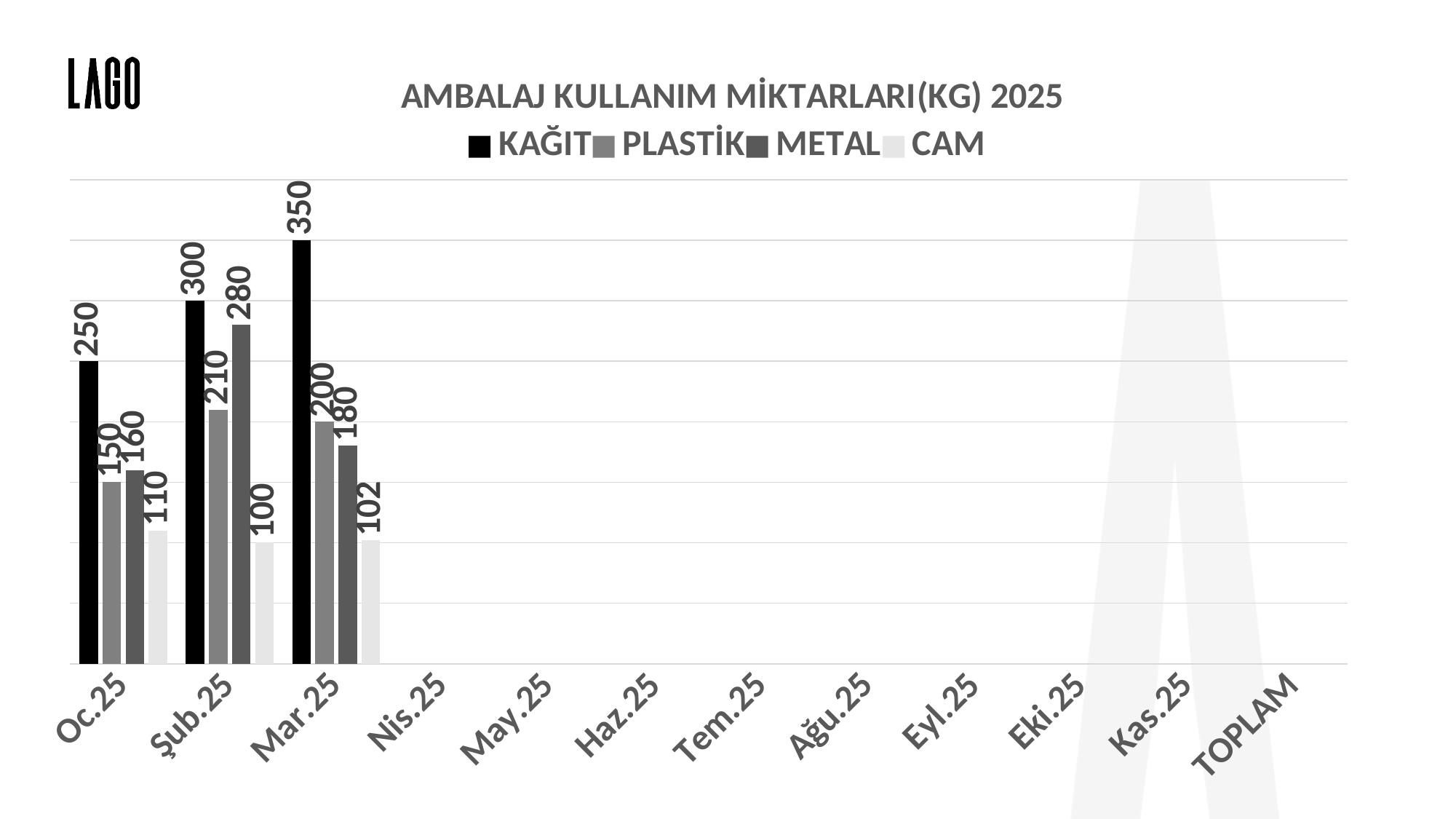
Do the KAĞIT values rise or fall from Oc.25 to Mar.25? Rise What is the KAĞIT value for Mar.25? 350 How many categories are shown on the x axis? 12 How many series does the legend list? 4 What is the CAM value for Oc.25? 110 In which month is the KAĞIT value highest? Mar.25 What kind of chart is shown on the slide? Bar chart What is the PLASTİK value for Şub.25? 210 Which is larger, the METAL value for Şub.25 or the METAL value for Mar.25? Şub.25 In which month is the CAM value lowest? Şub.25 What is the METAL value for Şub.25? 280 What is the difference between the KAĞIT values for Mar.25 and Oc.25? 100